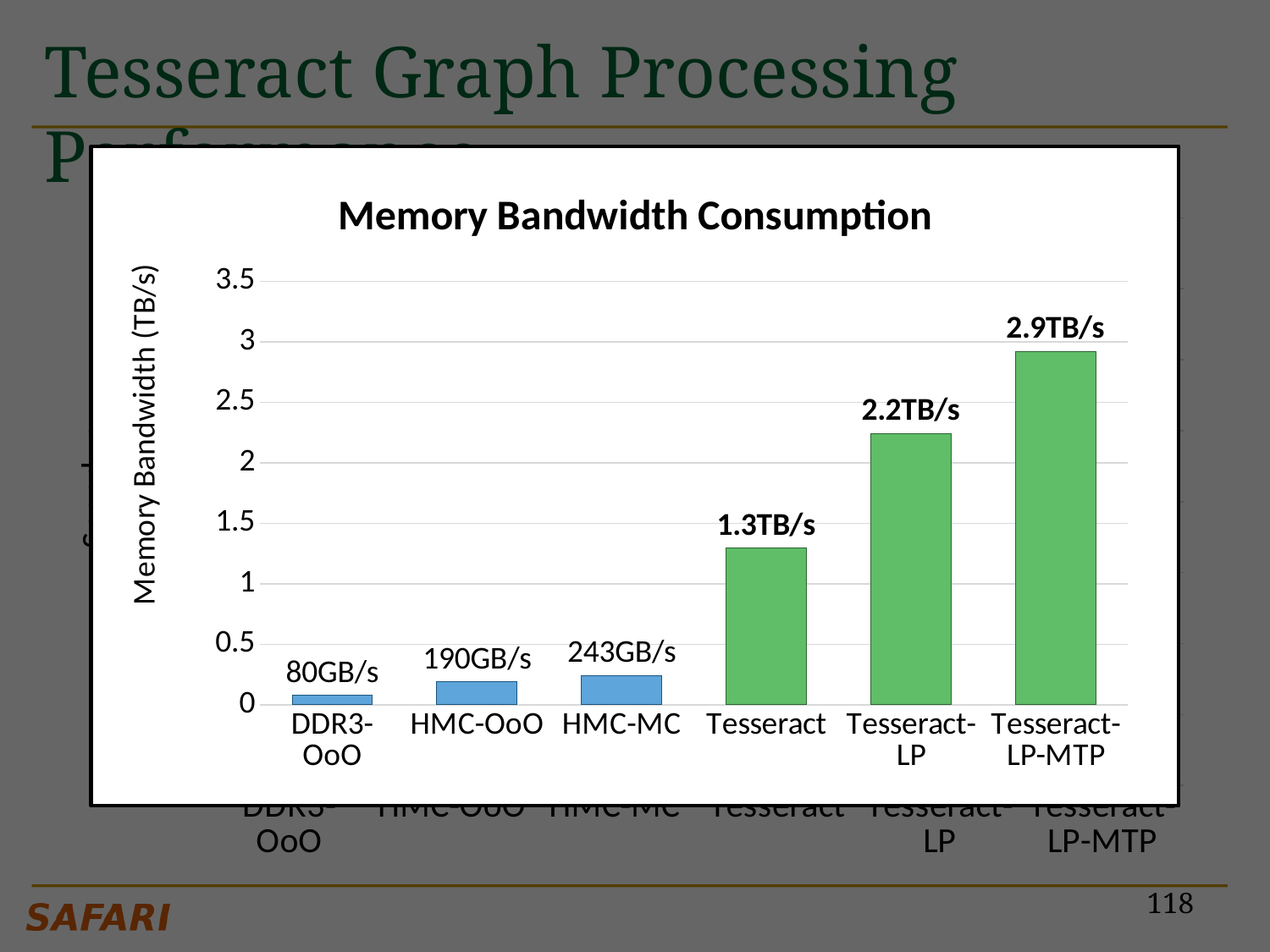
Is the memory bandwidth for Tesseract-LP greater or less than 2 TB/s? greater Which configuration has the lowest memory bandwidth consumption? DDR3-OoO What is the memory bandwidth consumption for Tesseract-LP-MTP? 2.9TB/s What is the memory bandwidth consumption for DDR3-OoO? 80GB/s What type of chart is used to show Memory Bandwidth Consumption? Bar chart Which has higher memory bandwidth consumption, Tesseract or HMC-OoO? Tesseract Which configuration has the highest memory bandwidth consumption? Tesseract-LP-MTP What is the difference in memory bandwidth between Tesseract-LP-MTP and Tesseract-LP? 0.7TB/s What is the difference in memory bandwidth between HMC-MC and HMC-OoO? 53GB/s What is the memory bandwidth consumption for Tesseract-LP? 2.2TB/s How many configurations are shown on the x axis of the chart? 6 What is the memory bandwidth consumption for HMC-MC? 243GB/s